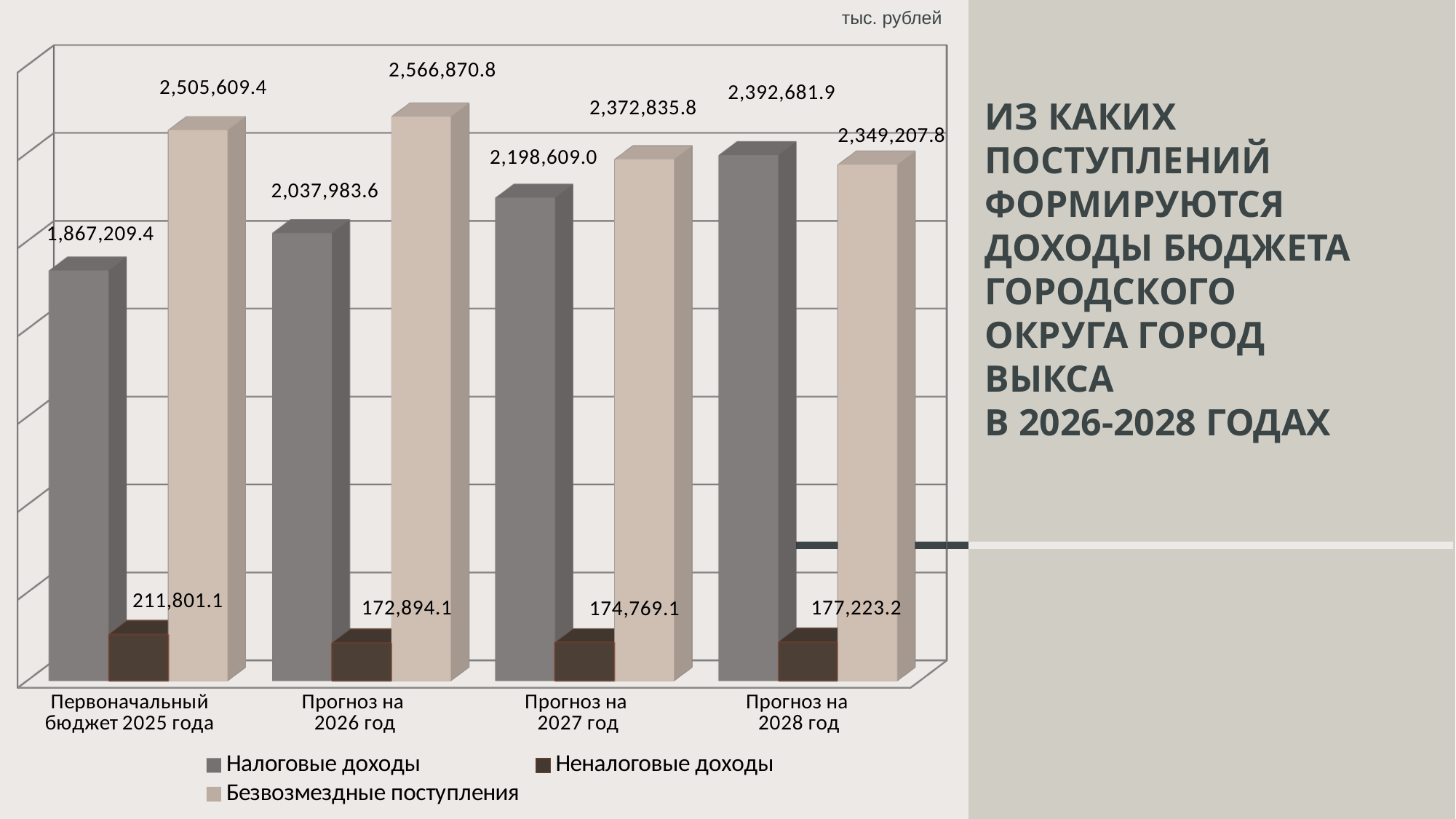
For Прогноз на 2028 год, which is larger: Налоговые доходы or Безвозмездные поступления? Налоговые доходы What is the difference between Безвозмездные поступления for Прогноз на 2026 год and for Первоначальный бюджет 2025 года? 61,261.4 How many categories are shown on the x axis? 4 In which category is Неналоговые доходы the lowest? Прогноз на 2026 год What kind of chart is shown on the slide? Bar chart Do the values for Налоговые доходы rise or fall from Первоначальный бюджет 2025 года to Прогноз на 2028 год? Rise What is the value of Налоговые доходы for Прогноз на 2027 год? 2,198,609.0 What is the value of Неналоговые доходы for Прогноз на 2028 год? 177,223.2 What is the difference between Налоговые доходы for Прогноз на 2028 год and for Первоначальный бюджет 2025 года? 525,472.5 What is the value of Безвозмездные поступления for Первоначальный бюджет 2025 года? 2,505,609.4 In which category is Безвозмездные поступления the highest? Прогноз на 2026 год How many series does the legend list? 3